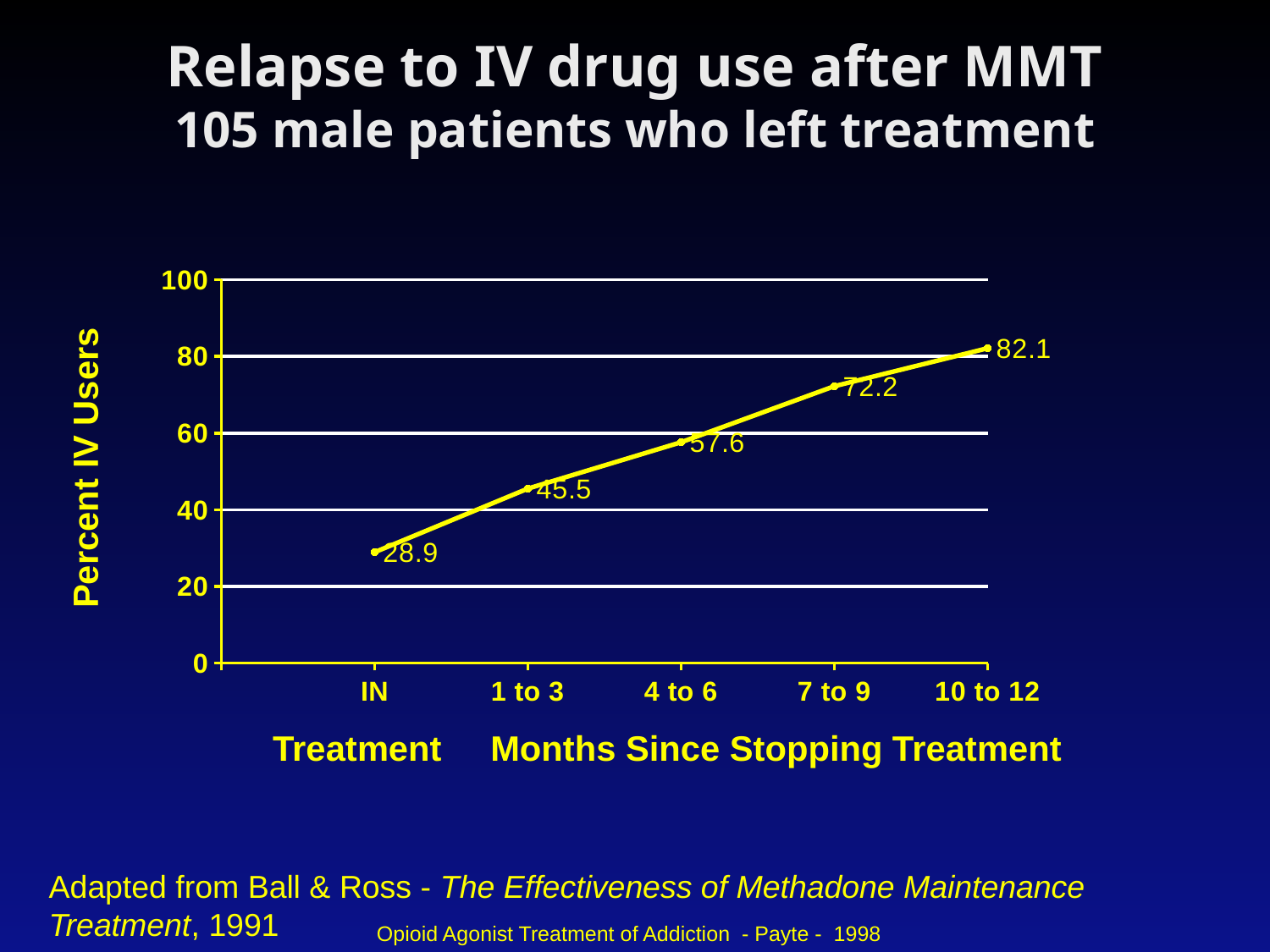
What is the percent of IV users at the 'IN' (in treatment) point? 28.9 Which point on the x axis has the highest percent of IV users? 10 to 12 What is the percent of IV users at 4 to 6 months since stopping treatment? 57.6 What is the difference in percent IV users between 10 to 12 months and the 'IN' treatment point? 53.2 What is the percent of IV users at 10 to 12 months since stopping treatment? 82.1 What kind of chart is shown on the slide? Line chart Do the values rise or fall along the x axis from 'IN' to '10 to 12'? Rise How many data points are plotted on the line? 5 Which point on the x axis has the lowest percent of IV users? IN Which is larger, the percent of IV users at 4 to 6 months or at 7 to 9 months? 7 to 9 What is the percent of IV users at 1 to 3 months since stopping treatment? 45.5 What is the percent of IV users at 7 to 9 months since stopping treatment? 72.2